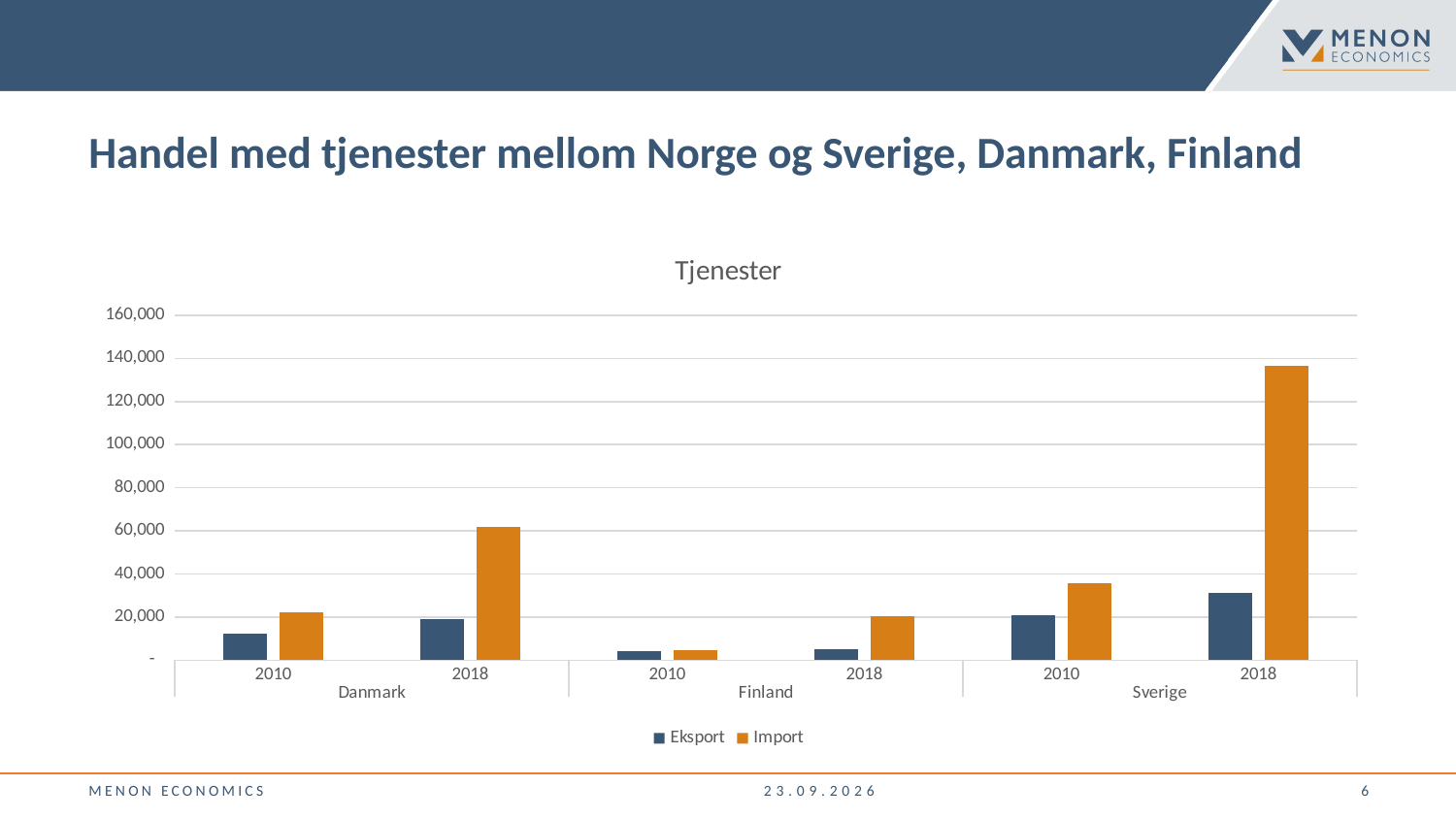
What are the two series named in the legend? Eksport and Import Which country and year has the highest Eksport bar? Sverige 2018 Is the Eksport value for Danmark in 2010 greater or less than 20,000? less Is the Import value for Sverige in 2018 greater or less than 120,000? greater Which is larger: the Import value for Danmark in 2018 or the Import value for Sverige in 2010? Import for Danmark in 2018 How many year categories (country-year groups) are shown along the x axis? 6 Which country and year has the lowest Import bar? Finland 2010 Does the Import value for Sverige rise or fall from 2010 to 2018? rise What kind of chart is shown on the slide? bar chart How many series does the legend list? 2 What is the title of the chart? Tjenester Which country and year has the highest Import bar? Sverige 2018